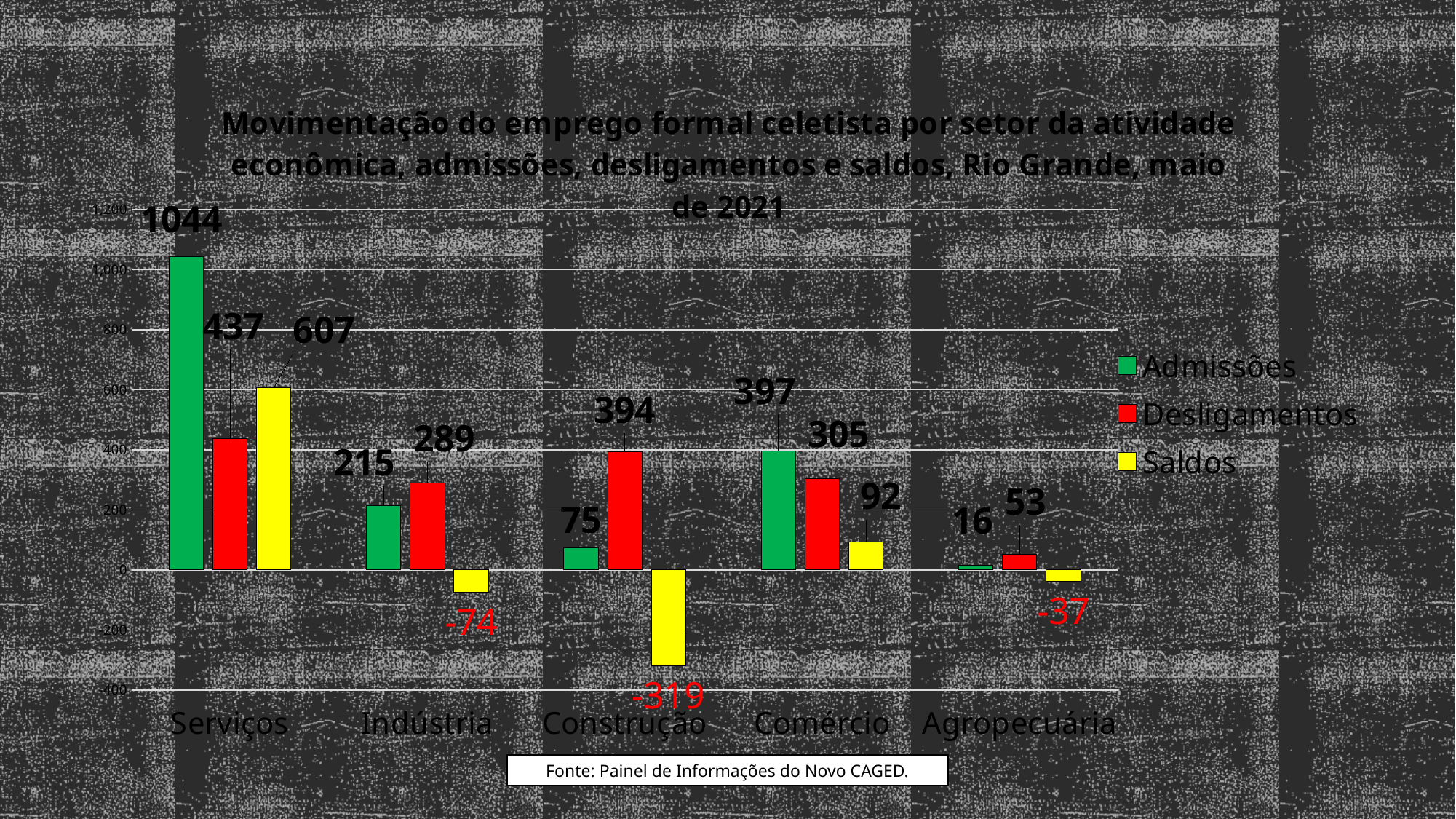
What kind of chart is shown on the slide? Bar chart What is the value of Admissões for Serviços? 1044 Which is larger for Comércio, Admissões or Desligamentos? Admissões Which sector has the highest value for Admissões? Serviços Is the value of Desligamentos for Serviços greater or less than 400? greater What is the value of Saldos for Construção? -319 What is the difference between Desligamentos and Admissões for Indústria? 74 What is the value of Desligamentos for Comércio? 305 How many sectors are shown on the x axis? 5 How many series does the legend list? 3 Which sector has the lowest value for Saldos? Construção What is the value of Saldos for Agropecuária? -37